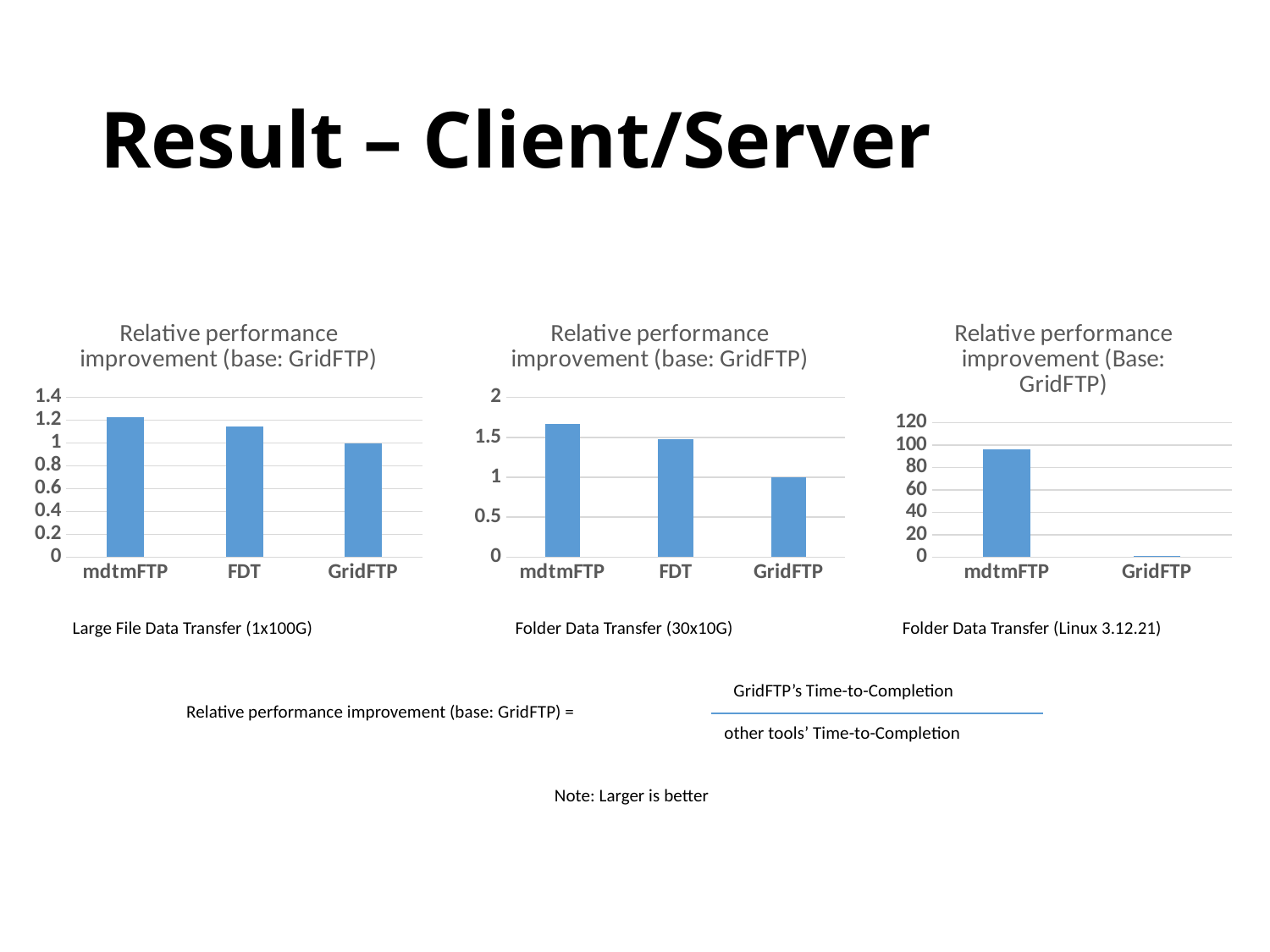
In the right chart (Folder Data Transfer (Linux 3.12.21)), is the value for mdtmFTP greater or less than 80? greater In the middle chart (Folder Data Transfer (30x10G)), what is the value for GridFTP? 1 In the left chart (Large File Data Transfer), which category has the lowest value? GridFTP How many categories are shown on the x axis of the right chart (Folder Data Transfer (Linux 3.12.21))? 2 In the left chart (Large File Data Transfer), which category has the highest value? mdtmFTP In the middle chart (Folder Data Transfer (30x10G)), which category has the highest value? mdtmFTP In the left chart (Large File Data Transfer), do the values rise or fall from mdtmFTP to GridFTP along the x axis? fall What kind of chart is the left chart (Large File Data Transfer)? bar chart In the right chart (Folder Data Transfer (Linux 3.12.21)), which is larger, mdtmFTP or GridFTP? mdtmFTP How many categories are shown on the x axis of the middle chart (Folder Data Transfer (30x10G))? 3 In the middle chart (Folder Data Transfer (30x10G)), is the value for mdtmFTP greater or less than 1.5? greater